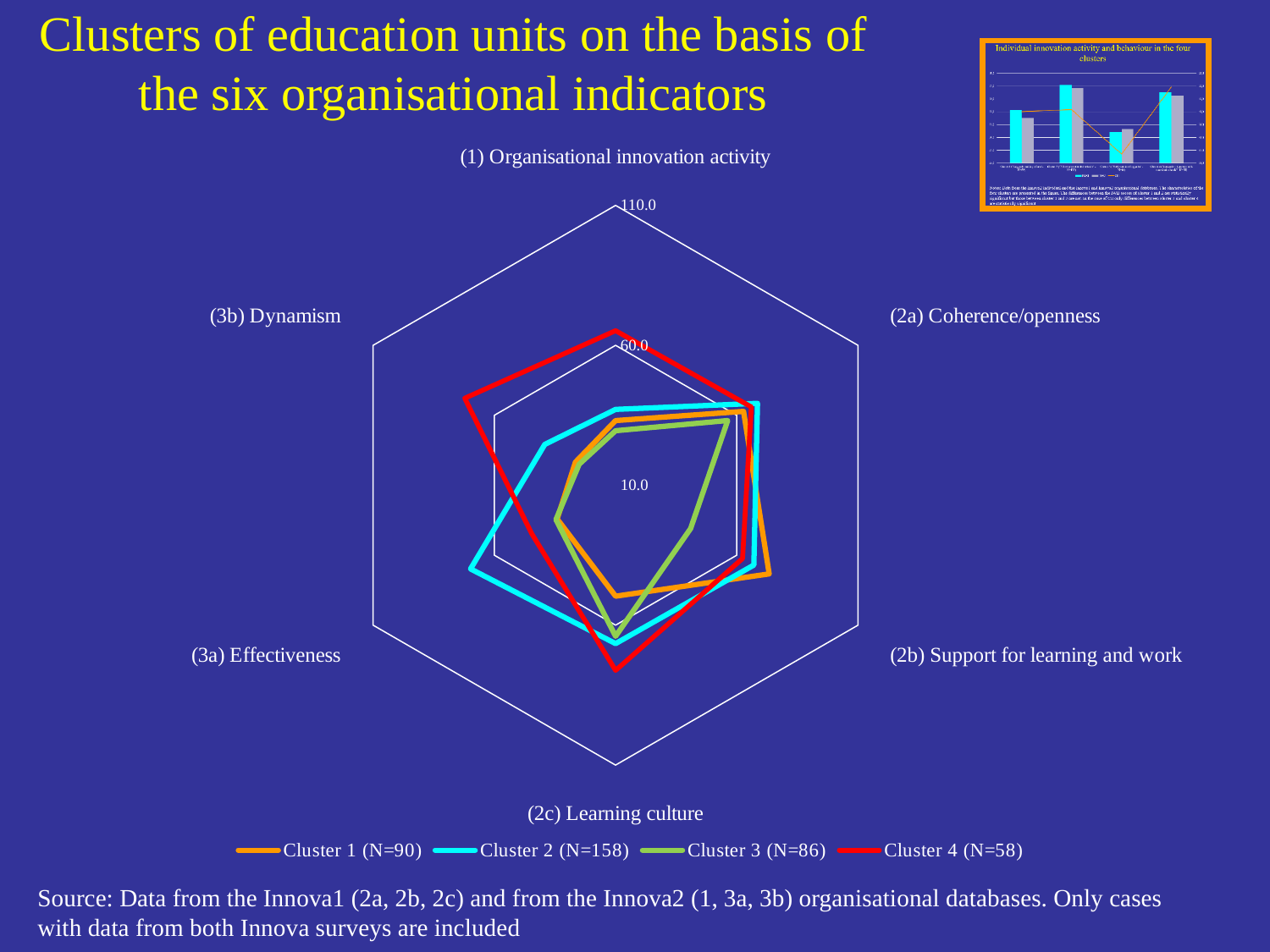
What is the highest value shown on the radar chart's axis scale? 110.0 Which cluster has the highest value on (1) Organisational innovation activity? Cluster 4 (N=58) On (3b) Dynamism, which is larger: the value for Cluster 4 or the value for Cluster 3? Cluster 4 According to the legend, how many cases are in Cluster 2? 158 How many indicator axes does the radar chart have? 6 What kind of chart is the main chart on the slide? Radar chart How many series does the legend of the radar chart list? 4 Is the value for Cluster 4 on (3b) Dynamism greater or less than 60.0? greater Is the value for Cluster 3 on (3a) Effectiveness greater or less than 60.0? less Is the value for Cluster 3 on (1) Organisational innovation activity greater or less than 60.0? less Which cluster has the highest value on (2c) Learning culture? Cluster 4 (N=58)